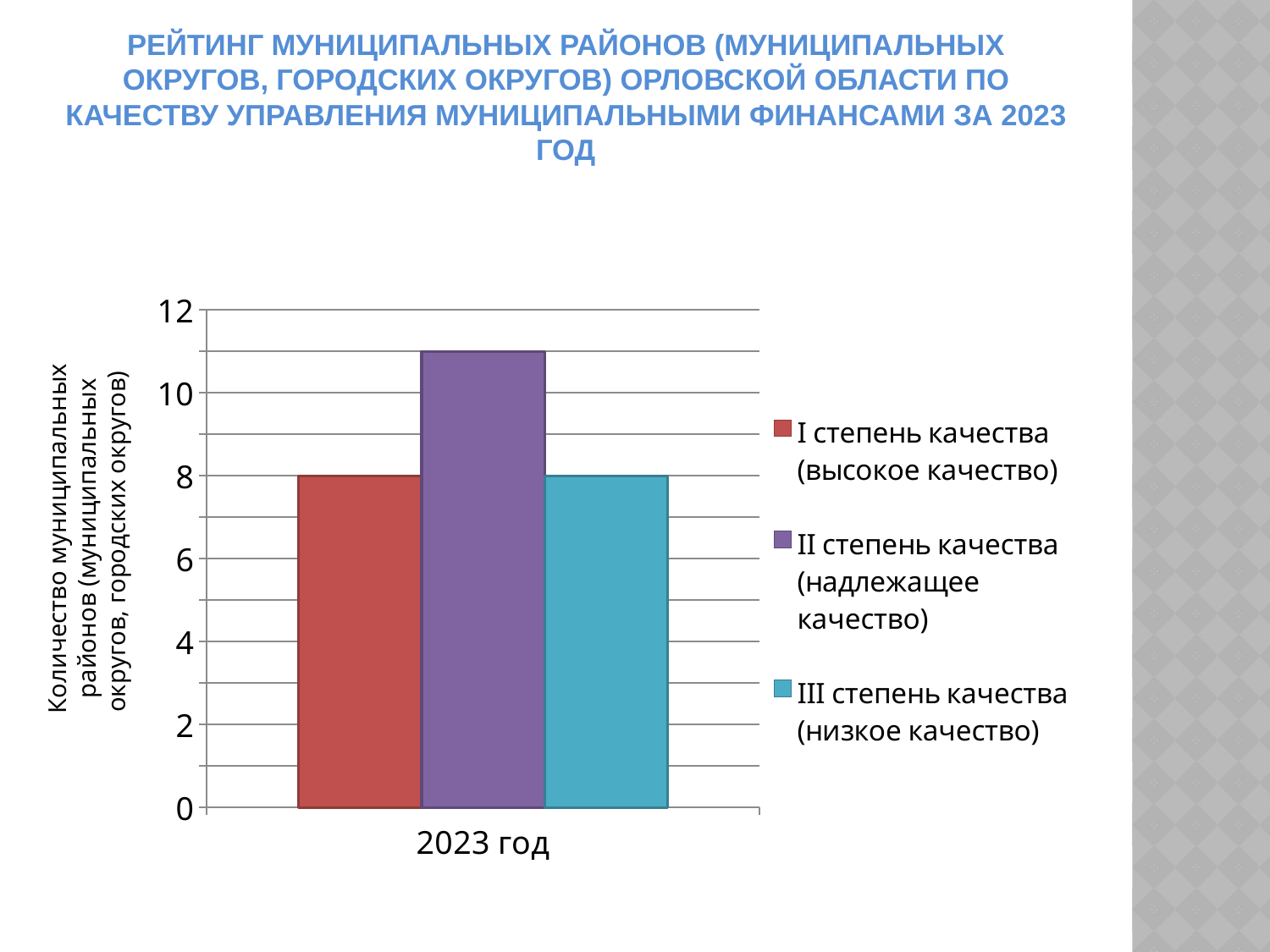
What colour is the bar for "II степень качества (надлежащее качество)"? purple What kind of chart is shown on the slide? bar chart What is the value for "III степень качества (низкое качество)" in 2023 год? 8 What is the label on the x axis of the chart? 2023 год Which series has the highest value in 2023 год? II степень качества (надлежащее качество) Which is larger: the value for "II степень качества" or the value for "I степень качества"? II степень качества How many categories are shown on the x axis? 1 Is the value for "II степень качества (надлежащее качество)" greater or less than 10? greater What is the difference between the values for "I степень качества" and "III степень качества"? 0 What is the value for "I степень качества (высокое качество)" in 2023 год? 8 Is the value for "II степень качества (надлежащее качество)" greater or less than 12? less How many series does the legend list? 3